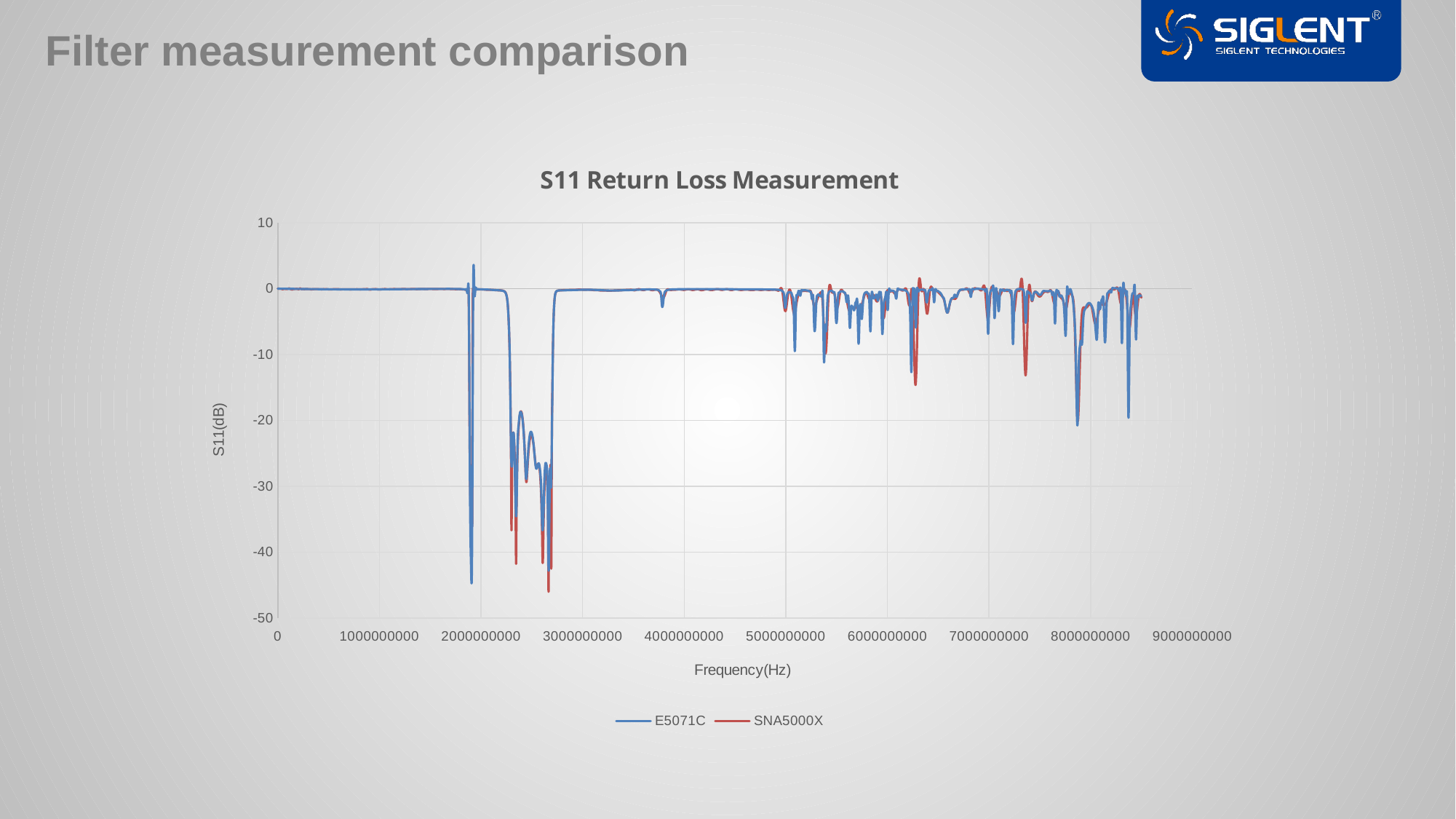
What is the label of the x axis? Frequency(Hz) Is the value of the E5071C series at 1000000000 Hz greater or less than -10 dB? greater What is the lowest value shown on the y axis? -50 What is the label of the y axis? S11(dB) How many series does the legend list? 2 Is the deepest dip of the SNA5000X series between 2000000000 and 3000000000 Hz greater or less than -40 dB? less What is the largest frequency tick shown on the x axis? 9000000000 What is the title of the chart? S11 Return Loss Measurement What are the names of the two series in the legend? E5071C and SNA5000X What is the highest value shown on the y axis? 10 What kind of chart is shown on the slide? Line chart Is the deepest dip of the E5071C series near 2000000000 Hz greater or less than -40 dB? less